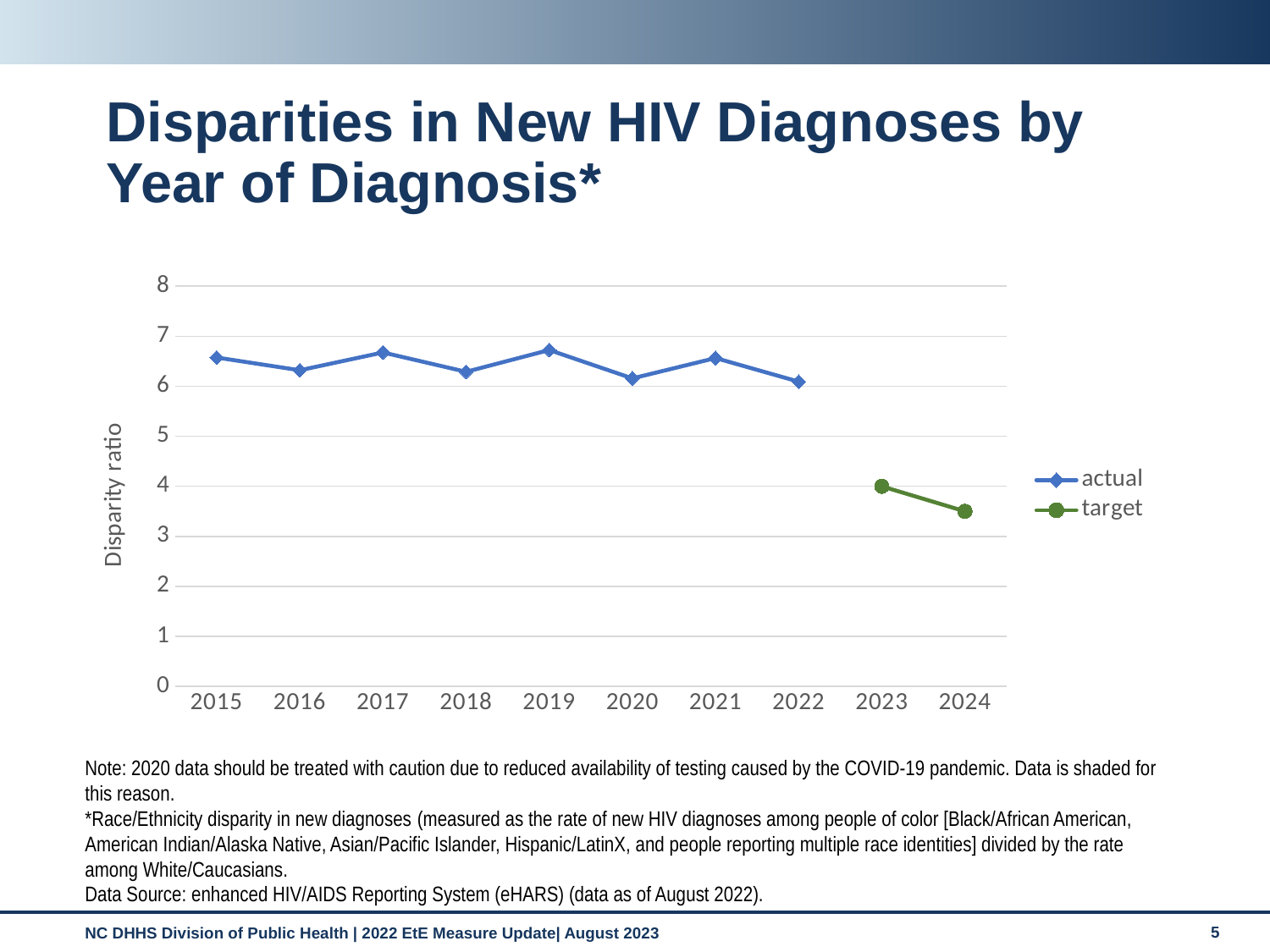
Which is larger, the actual value for 2022 or the target value for 2023? actual value for 2022 Does the target series rise or fall from 2023 to 2024? fall How many years are shown on the x axis? 10 What is the label of the y axis? Disparity ratio Is the target value for 2024 greater or less than 4? less What kind of chart is shown on the slide? line chart How many series does the legend list? 2 Is the actual value for 2022 greater or less than 7? less What is the target value for 2023? 4 Is the actual value for 2015 greater or less than 6? greater Which is larger, the actual value for 2017 or the actual value for 2020? 2017 What are the two series named in the legend? actual and target